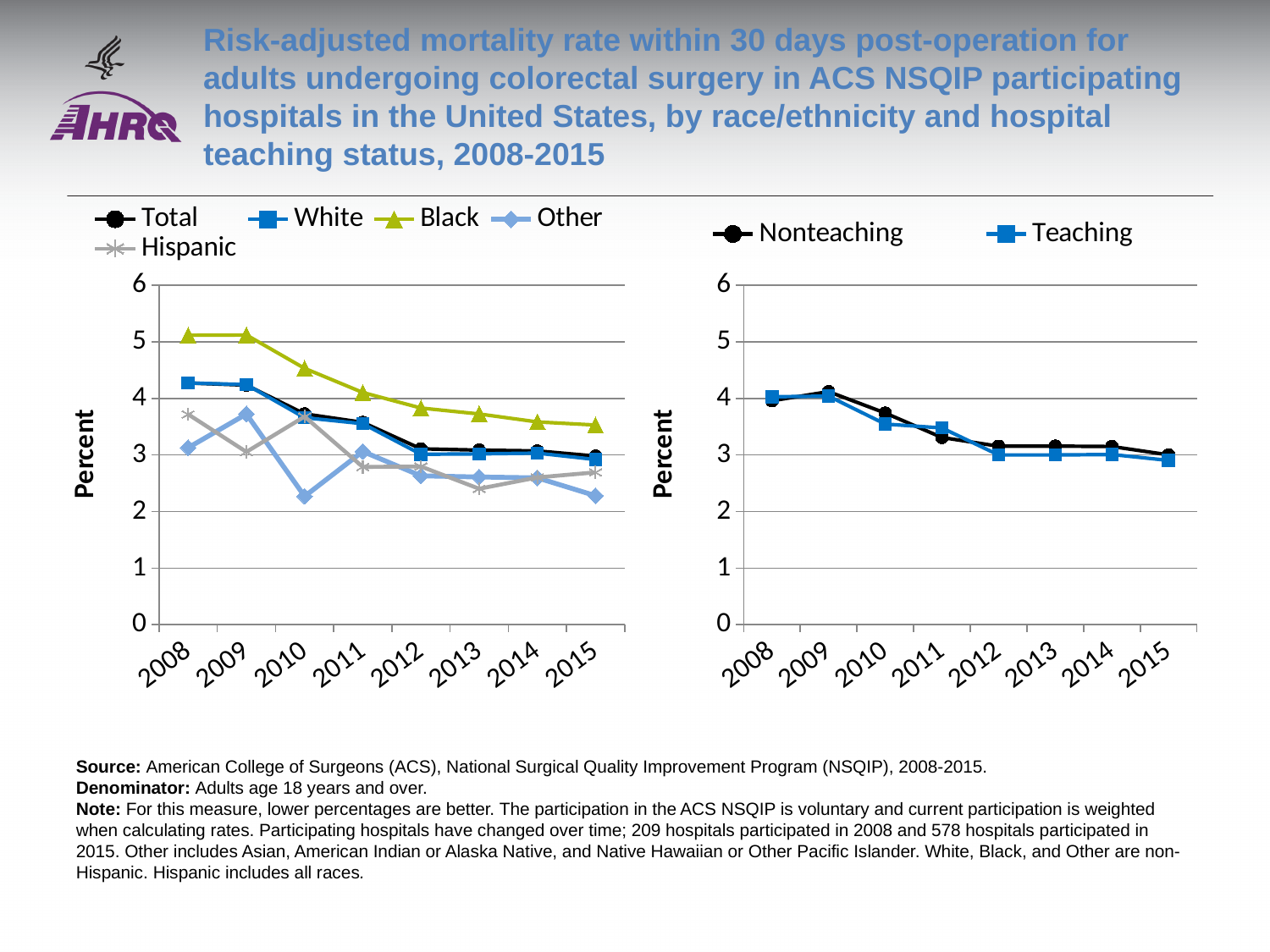
In the left chart (by race/ethnicity), is the value for Black in 2008 greater or less than 5? greater How many series does the legend of the left chart (by race/ethnicity) list? 5 In the left chart (by race/ethnicity), is the value for Black in 2015 greater or less than 4? less In the left chart (by race/ethnicity), which is larger in 2015, the value for Black or the value for Other? Black What kind of chart is the left chart (by race/ethnicity)? line chart In the right chart (by hospital teaching status), does the Nonteaching series rise or fall from 2009 to 2015? fall In the right chart (by hospital teaching status), is the value for Teaching in 2010 greater or less than 4? less In the left chart (by race/ethnicity), does the Black series rise or fall from 2008 to 2015? fall How many series does the legend of the right chart (by hospital teaching status) list? 2 How many years are plotted along the x axis of the right chart (by hospital teaching status)? 8 In the left chart (by race/ethnicity), which group has the highest mortality rate in 2008? Black